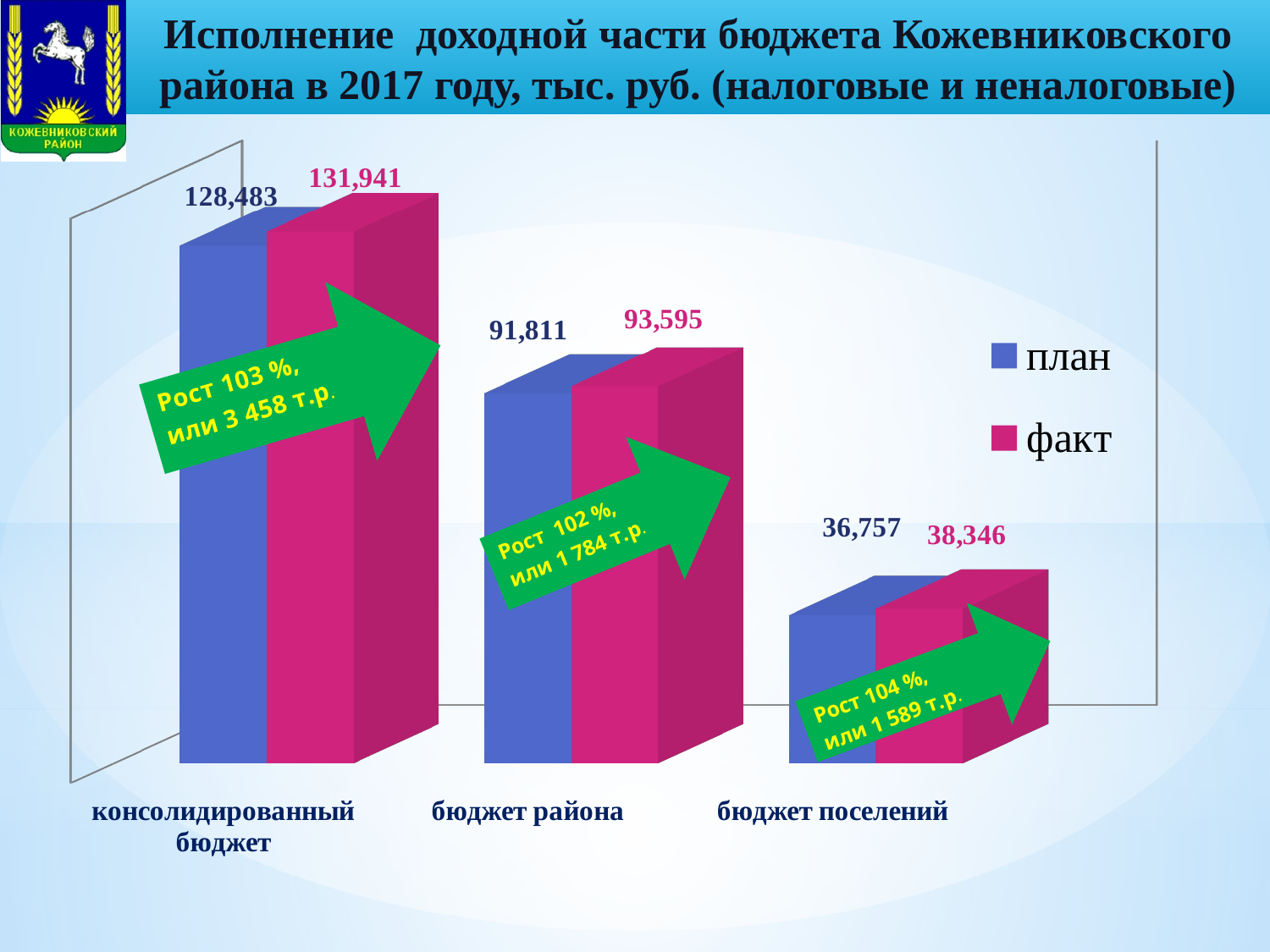
What is the план value for консолидированный бюджет? 128,483 What is the факт value for бюджет поселений? 38,346 What is the difference between the факт and план values for бюджет района? 1,784 What is the difference between the факт and план values for бюджет поселений? 1,589 What kind of chart is shown on the slide? bar chart How many series does the legend list? 2 How many categories are shown on the x axis? 3 What is the план value for бюджет района? 91,811 What is the факт value for консолидированный бюджет? 131,941 Which category has the lowest факт value? бюджет поселений Which is larger for консолидированный бюджет, план or факт? факт Which category has the highest план value? консолидированный бюджет